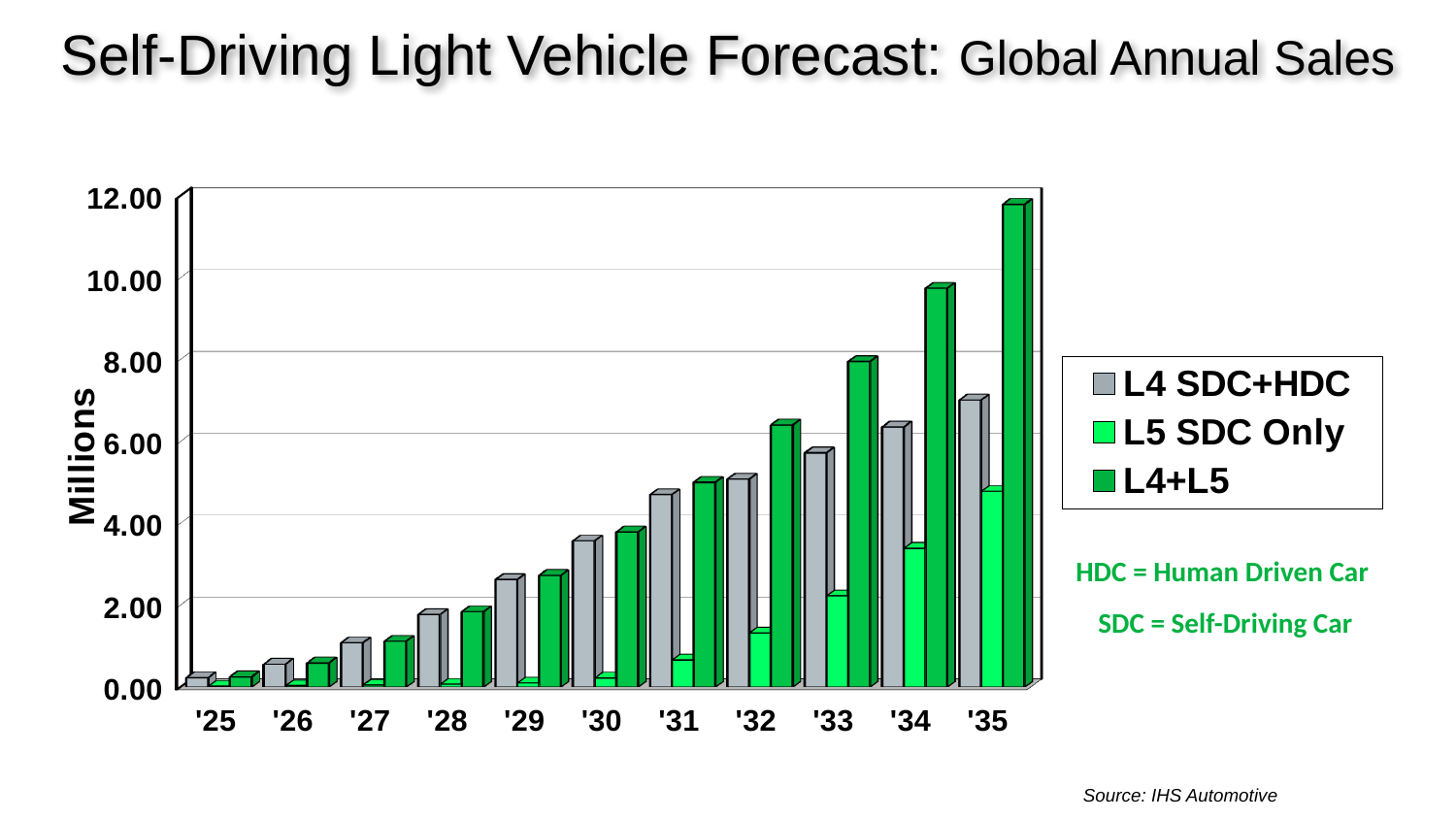
Is the L5 SDC Only value for '35 greater or less than 4.00? greater How many series does the legend list? 3 In which year is the L4+L5 value highest? '35 Do the L4+L5 values rise or fall from '25 to '35? rise What kind of chart is shown on the slide? bar chart In which year is the L4 SDC+HDC value lowest? '25 Is the L4 SDC+HDC value for '35 greater or less than 6.00? greater Is the L4+L5 value for '30 greater or less than 4.00? less Which is larger in '34, L4 SDC+HDC or L5 SDC Only? L4 SDC+HDC How many years are shown on the x axis? 11 What is the label on the vertical axis? Millions